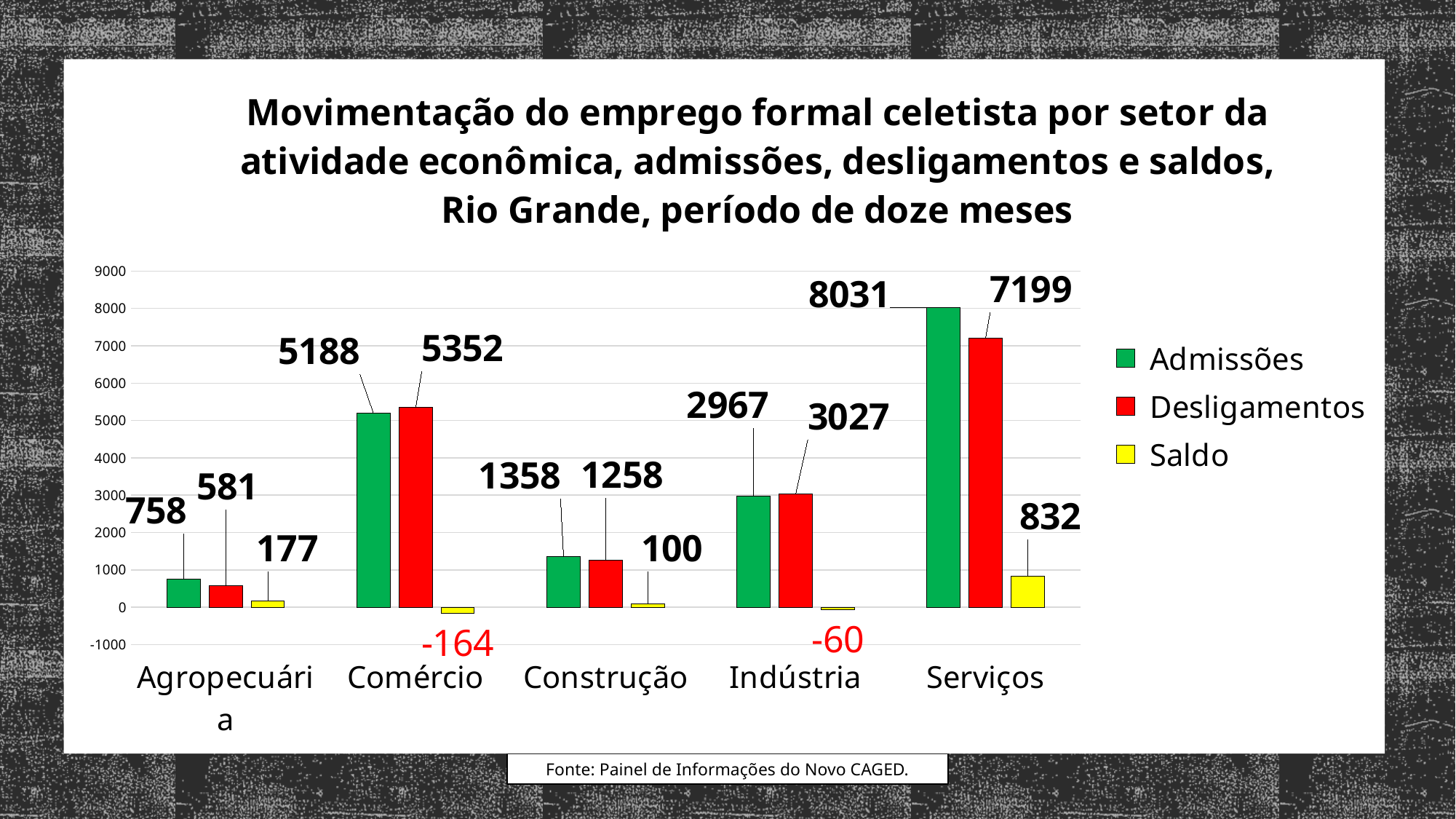
What kind of chart is shown on the slide? bar chart What colour represents the Saldo series? yellow What is the Admissões value for Serviços? 8031 What is the difference between Admissões and Desligamentos for Construção? 100 How many sectors are shown on the x axis? 5 Which sector has the highest Admissões value? Serviços Is the Admissões value for Indústria greater or less than 2000? greater What is the Saldo value for Indústria? -60 Which is larger for Comércio, Admissões or Desligamentos? Desligamentos How many series does the legend list? 3 Which sector has the lowest Desligamentos value? Agropecuária What is the Desligamentos value for Comércio? 5352